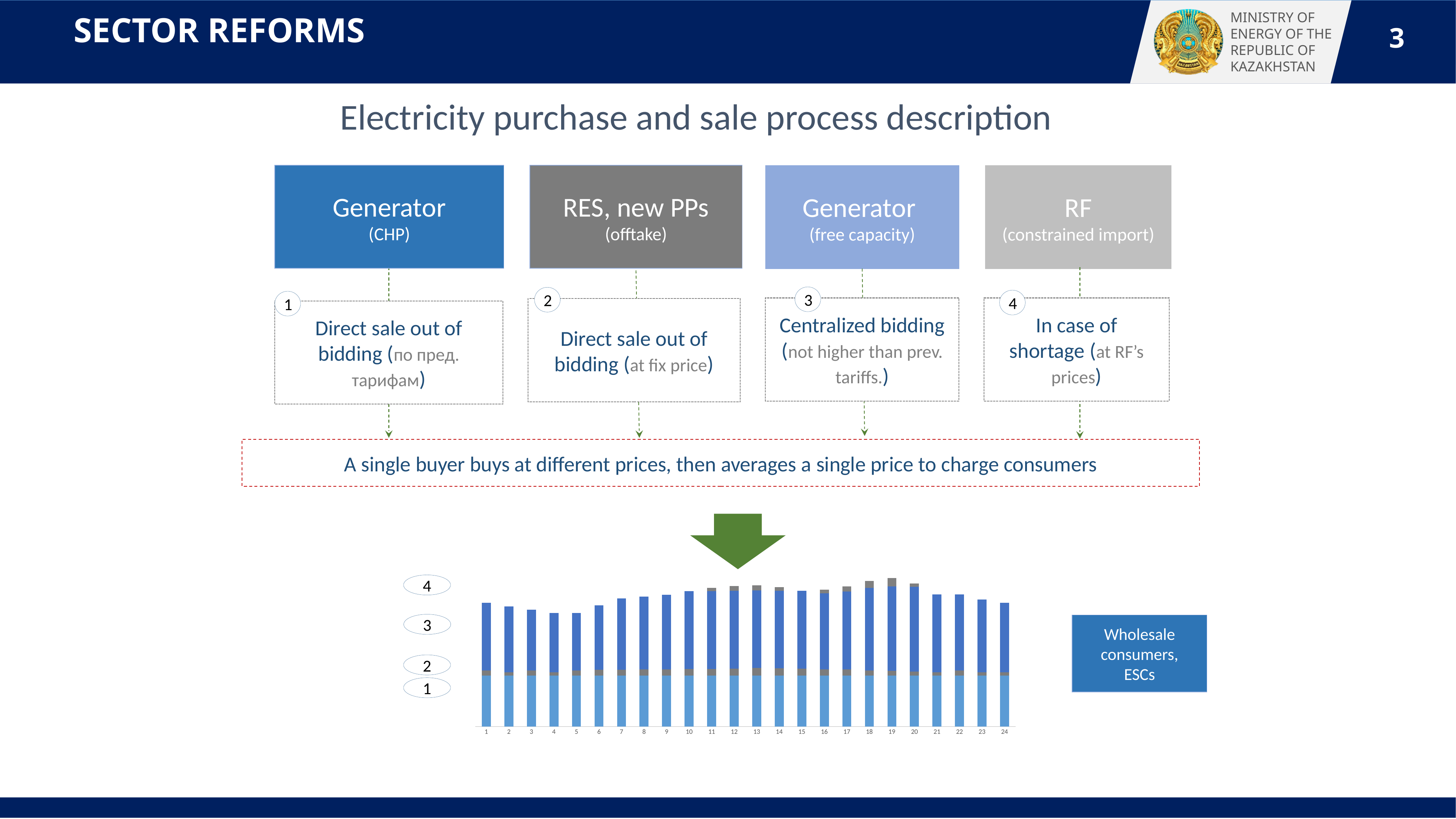
What kind of chart is shown at the bottom of the slide? Stacked bar chart Do the bar heights rise or fall from category 20 to category 24? Fall Which bar is taller, category 13 or category 3? 13 What colour is the bottom segment of each stacked bar? Light blue Is the bar for category 1 taller or shorter than the bar for category 5? Taller Which bar is taller, category 19 or category 24? 19 Do the bar heights rise or fall from category 5 to category 13? Rise Do the bar heights rise or fall from category 1 to category 5? Fall How many categories are shown along the x axis of the bar chart? 24 What is the label of the box to the right of the bar chart? Wholesale consumers, ESCs Which category has the tallest bar in the chart? 19